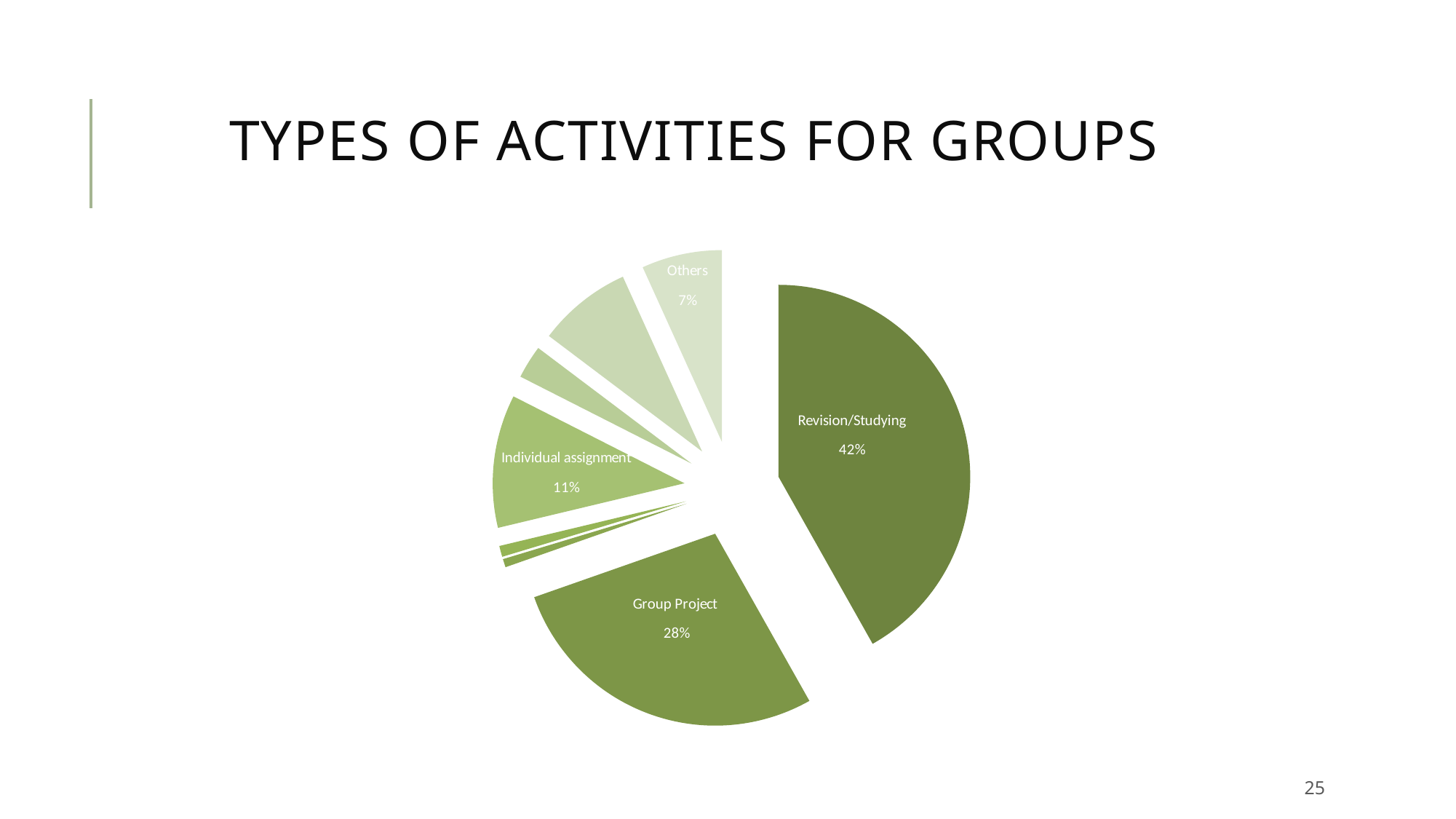
What percentage of the pie is Group Project? 28% What kind of chart is shown on the slide? pie chart What is the difference in percentage points between Revision/Studying and Group Project? 14 What percentage of the pie is Revision/Studying? 42% What is the title of the slide? TYPES OF ACTIVITIES FOR GROUPS What percentage of the pie is Others? 7% What is the combined share of Revision/Studying and Group Project? 70% What is the difference in percentage points between Individual assignment and Others? 4 Which activity has the largest slice of the pie? Revision/Studying What percentage of the pie is Individual assignment? 11% Which is larger, the Others slice or the Individual assignment slice? Individual assignment Which is larger, the Group Project slice or the Individual assignment slice? Group Project